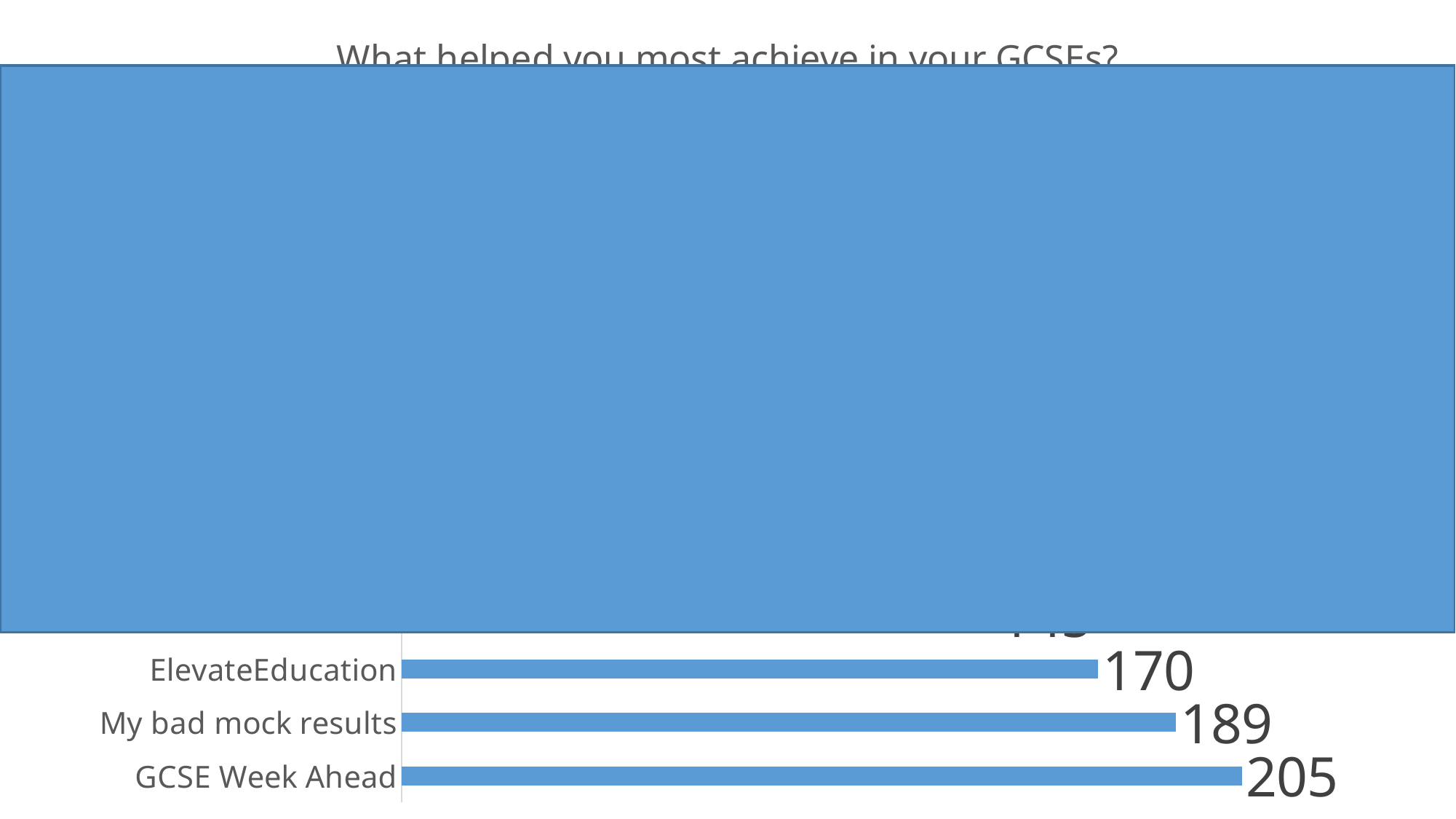
Which is larger, the value for GCSE Week Ahead or the value for ElevateEducation? GCSE Week Ahead What is the value for GCSE Week Ahead? 205 What is the difference between the values for My bad mock results and ElevateEducation? 19 What kind of chart is shown on the slide? Bar chart Which is larger, the value for My bad mock results or the value for ElevateEducation? My bad mock results What is the title of the chart? What helped you most achieve in your GCSEs? What is the value for My bad mock results? 189 What is the difference between the values for GCSE Week Ahead and My bad mock results? 16 What is the value for ElevateEducation? 170 What is the difference between the values for GCSE Week Ahead and ElevateEducation? 35 What colour are the bars in the chart? Blue